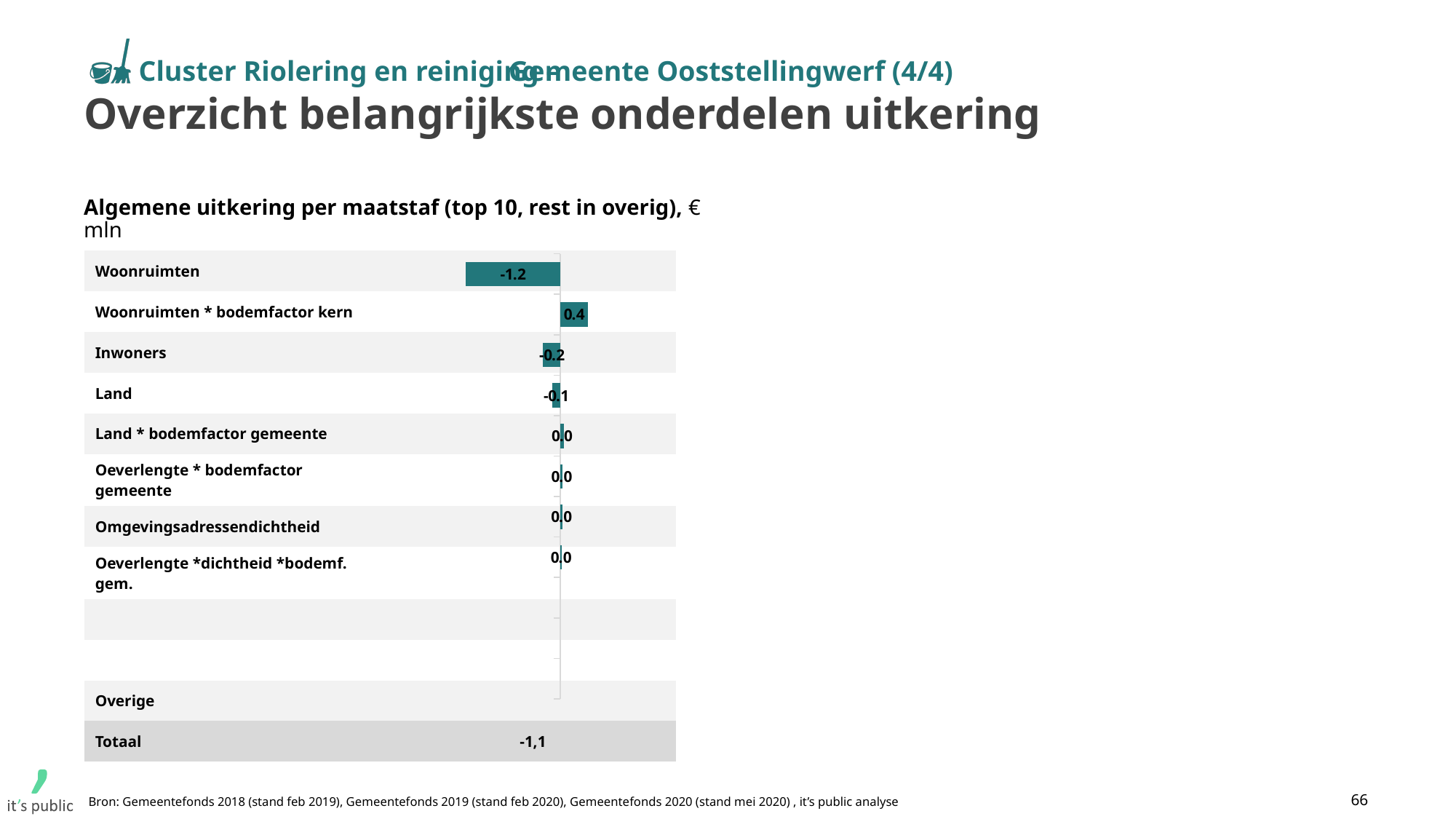
What is the value for Omgevingsadressendichtheid? 0.0 What is the value for Land? -0.1 What is the value for Inwoners? -0.2 What is the Totaal value shown at the bottom of the chart? -1,1 What kind of chart is shown on the slide? Bar chart What is the difference between the values for Woonruimten * bodemfactor kern and Inwoners? 0.6 Which category has the lowest (most negative) value? Woonruimten What is the value for Woonruimten? -1.2 What is the title of the chart? Algemene uitkering per maatstaf (top 10, rest in overig), € mln Which category has the highest value? Woonruimten * bodemfactor kern Which is larger, the value for Inwoners or the value for Land? Land What is the value for Woonruimten * bodemfactor kern? 0.4